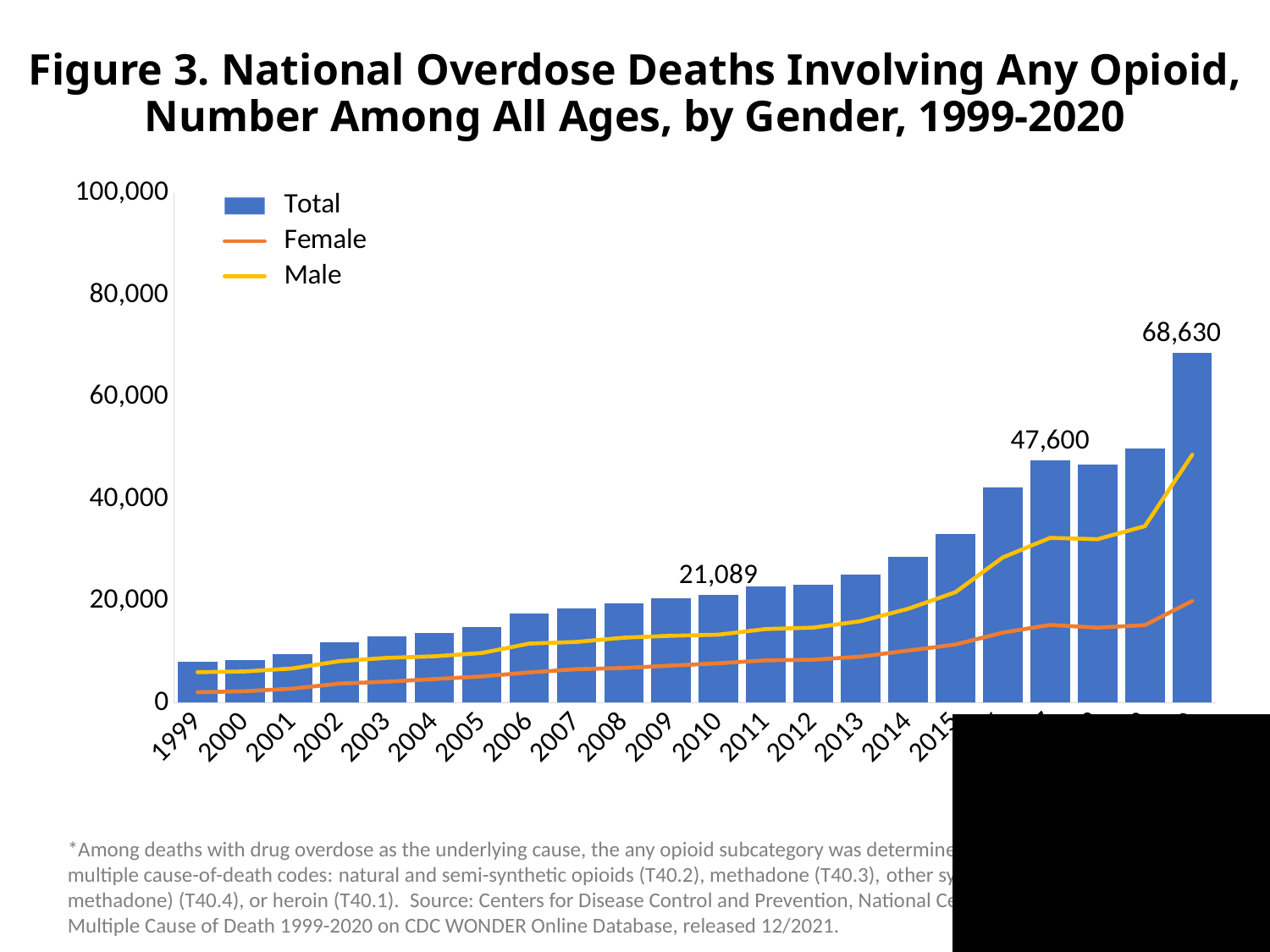
What is the value printed on the tallest bar in the chart? 68,630 How many series does the legend list? 3 Do the Total values generally rise or fall from 1999 to the last year shown? Rise What is the difference between the highest labeled Total value and the Total value for 2010? 47,541 Is the Total value for 1999 greater or less than 20,000? less What is the total number of overdose deaths shown for 2010? 21,089 Which colour is used for the Male line? Yellow What kind of chart is used to show the Total series? Bar chart In 2015, which line is higher, Male or Female? Male Is the Total value for 2015 greater or less than 20,000? greater Which year has the lowest Total bar? 1999 What is the difference between the labeled values 68,630 and 47,600? 21,030